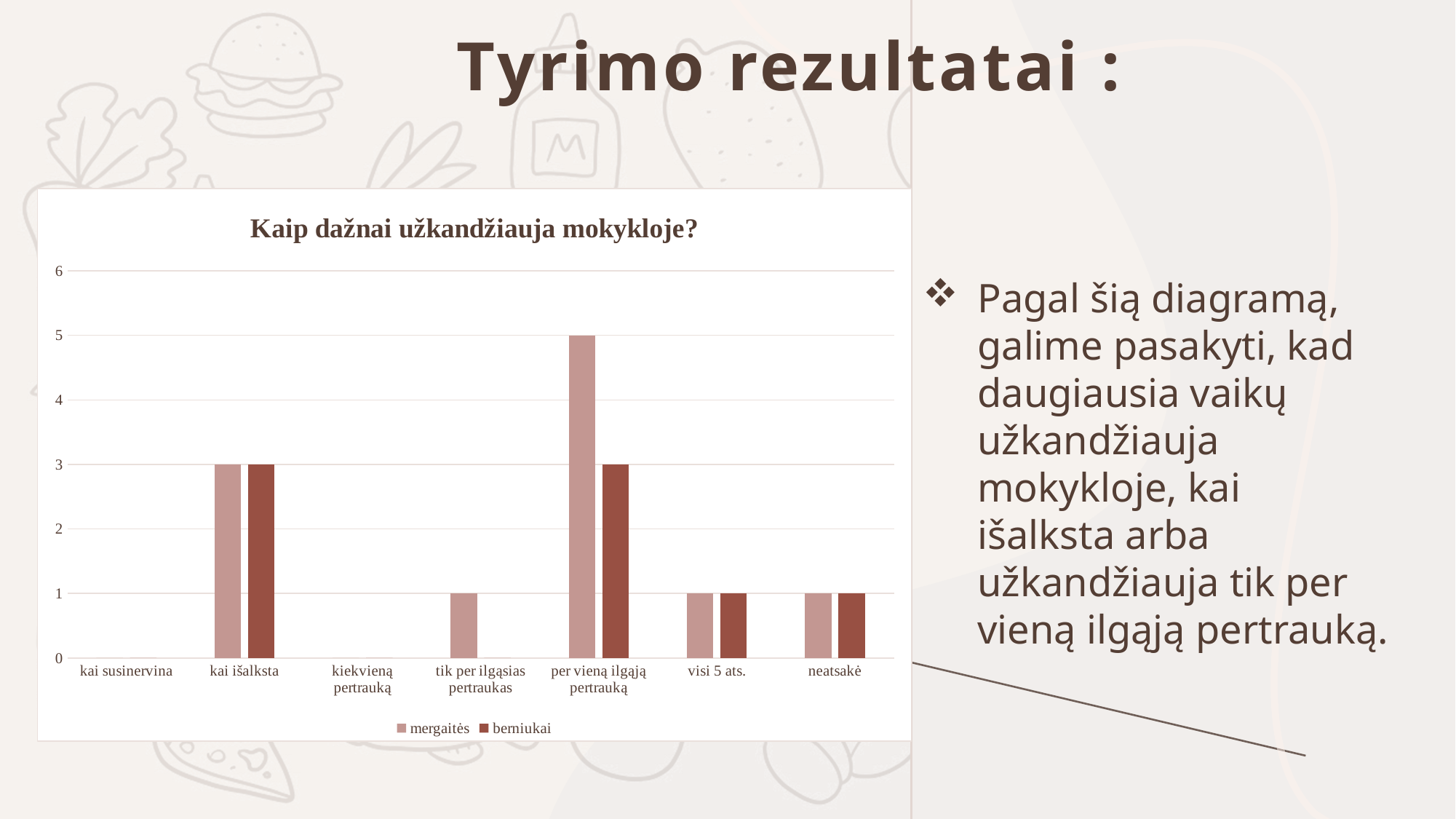
What is the value for mergaitės in the category 'per vieną ilgąją pertrauką'? 5 What is the title of the chart? Kaip dažnai užkandžiauja mokykloje? In the category 'per vieną ilgąją pertrauką', which series has the larger value, mergaitės or berniukai? mergaitės What is the value for berniukai in the category 'visi 5 ats.'? 1 Which category has the highest value for mergaitės? per vieną ilgąją pertrauką What kind of chart is shown on the slide? bar chart What is the difference between the mergaitės and berniukai values in the category 'per vieną ilgąją pertrauką'? 2 What is the value for mergaitės in the category 'tik per ilgąsias pertraukas'? 1 How many categories are shown on the x axis of the chart? 7 Is the value for mergaitės in 'per vieną ilgąją pertrauką' greater or less than 4? greater What is the value for berniukai in the category 'kai išalksta'? 3 How many series does the chart legend list? 2